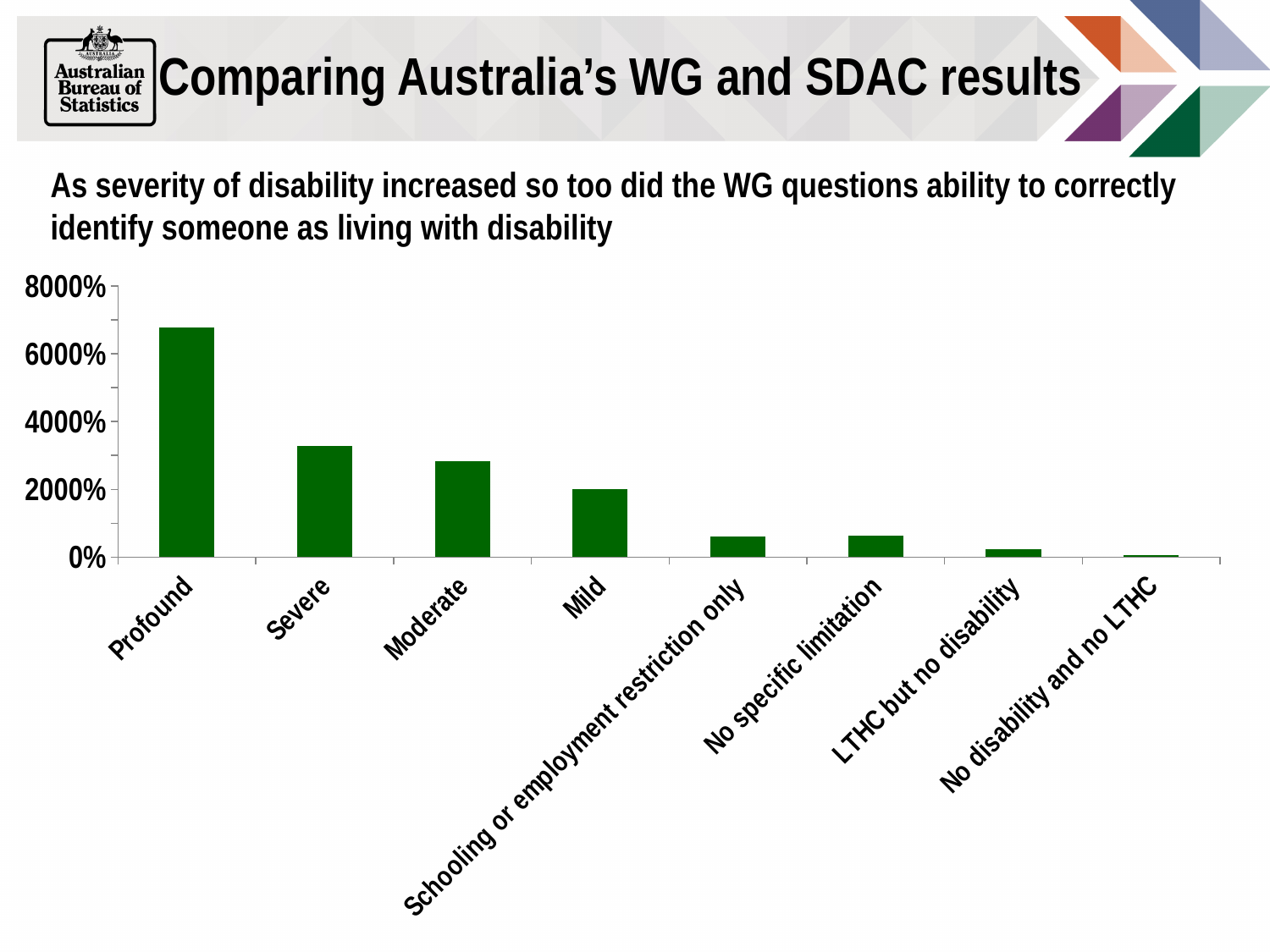
Is the value for Severe greater or less than 4000%? less How many categories are shown on the x axis of the chart? 8 Is the value for Moderate greater or less than 2000%? greater Is the value for LTHC but no disability greater or less than 2000%? less Do the bar values generally rise or fall moving from Profound on the left to No disability and no LTHC on the right? fall Which is larger, the value for Moderate or the value for Mild? Moderate Which is larger, the value for Profound or the value for Severe? Profound Which category has the highest bar in the chart? Profound Which category has the lowest bar in the chart? No disability and no LTHC What kind of chart is shown on the slide? bar chart What is the title of the slide containing the chart? Comparing Australia's WG and SDAC results